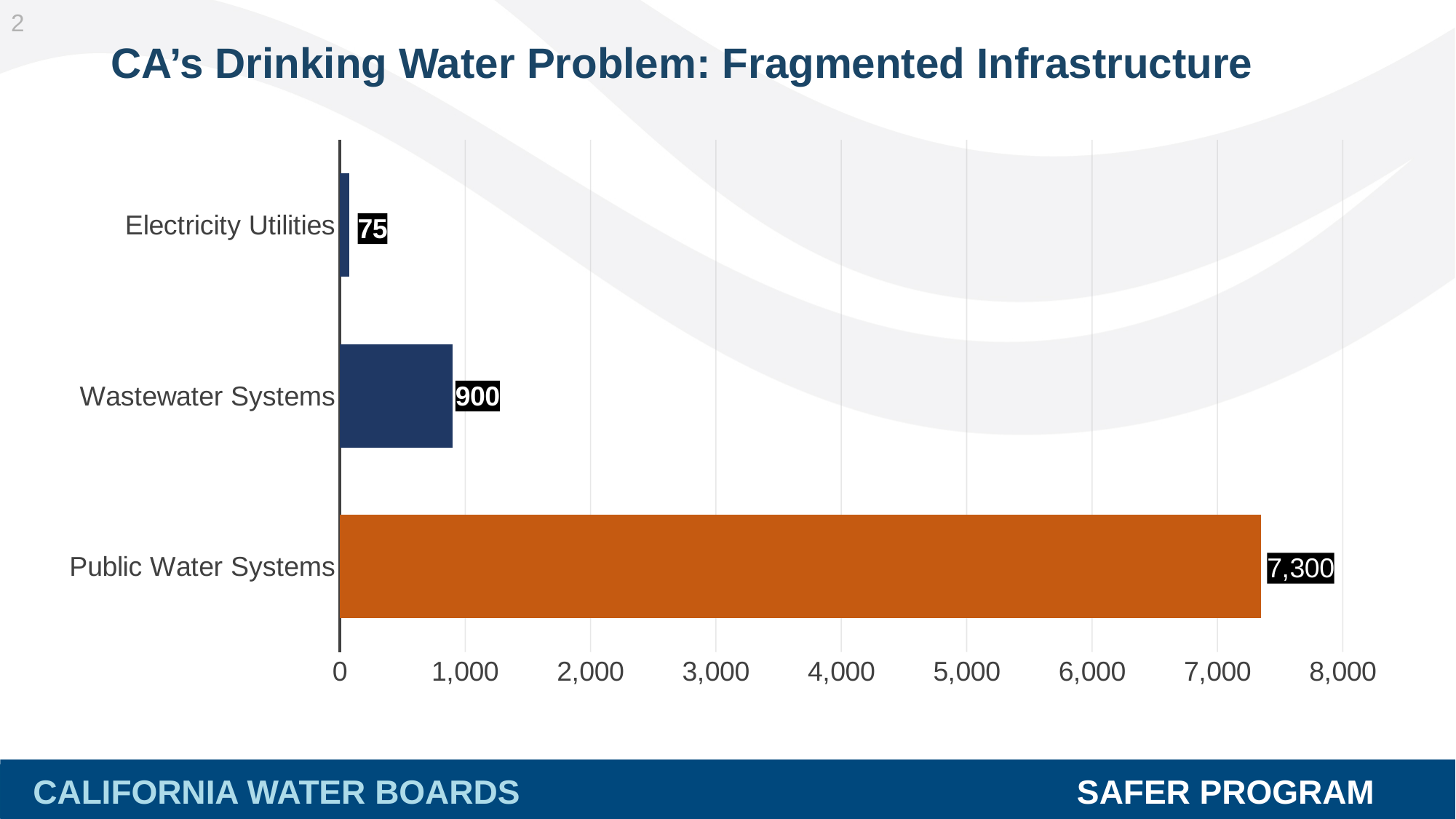
Which category has the lowest value? Electricity Utilities What is the value for Electricity Utilities? 75 What is the difference between the values for Public Water Systems and Wastewater Systems? 6,400 What kind of chart is shown on the slide? bar chart What is the value for Wastewater Systems? 900 Which is larger, the value for Wastewater Systems or the value for Electricity Utilities? Wastewater Systems Is the value for Public Water Systems greater or less than 7,000? greater What is the difference between the values for Wastewater Systems and Electricity Utilities? 825 How many categories are shown in the chart? 3 What is the value for Public Water Systems? 7,300 What is the title of the slide containing the chart? CA's Drinking Water Problem: Fragmented Infrastructure Which category has the highest value? Public Water Systems